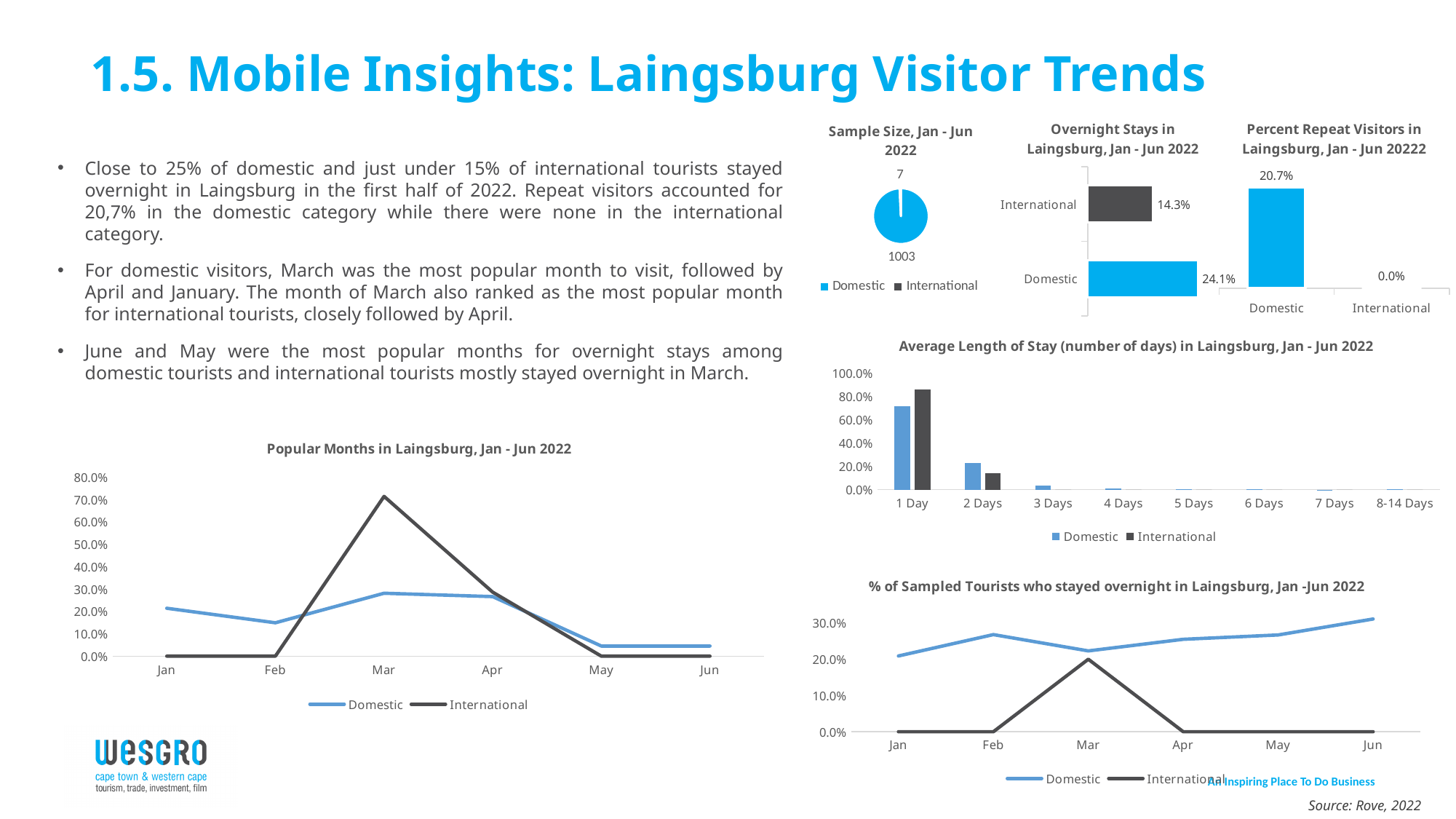
In the 'Overnight Stays in Laingsburg, Jan - Jun 2022' chart, what is the value for Domestic? 24.1% In the 'Average Length of Stay (number of days) in Laingsburg, Jan - Jun 2022' chart, is the International value for 1 Day greater or less than 80.0%? greater In the 'Average Length of Stay (number of days) in Laingsburg, Jan - Jun 2022' chart, how many categories are shown on the x axis? 8 In the 'Sample Size, Jan - Jun 2022' pie chart, what is the value for Domestic? 1003 In the 'Overnight Stays in Laingsburg, Jan - Jun 2022' chart, what is the value for International? 14.3% In the 'Percent Repeat Visitors in Laingsburg' chart, what is the value for Domestic? 20.7% In the 'Overnight Stays in Laingsburg, Jan - Jun 2022' chart, what is the difference between the Domestic and International values? 9.8% In the 'Percent Repeat Visitors in Laingsburg' chart, which category has the lowest value? International What kind of chart is 'Popular Months in Laingsburg, Jan - Jun 2022'? Line chart In the 'Popular Months in Laingsburg, Jan - Jun 2022' chart, which month has the highest International value? Mar In the '% of Sampled Tourists who stayed overnight in Laingsburg, Jan -Jun 2022' chart, how many series does the legend list? 2 In the 'Sample Size, Jan - Jun 2022' pie chart, what is the value for International? 7